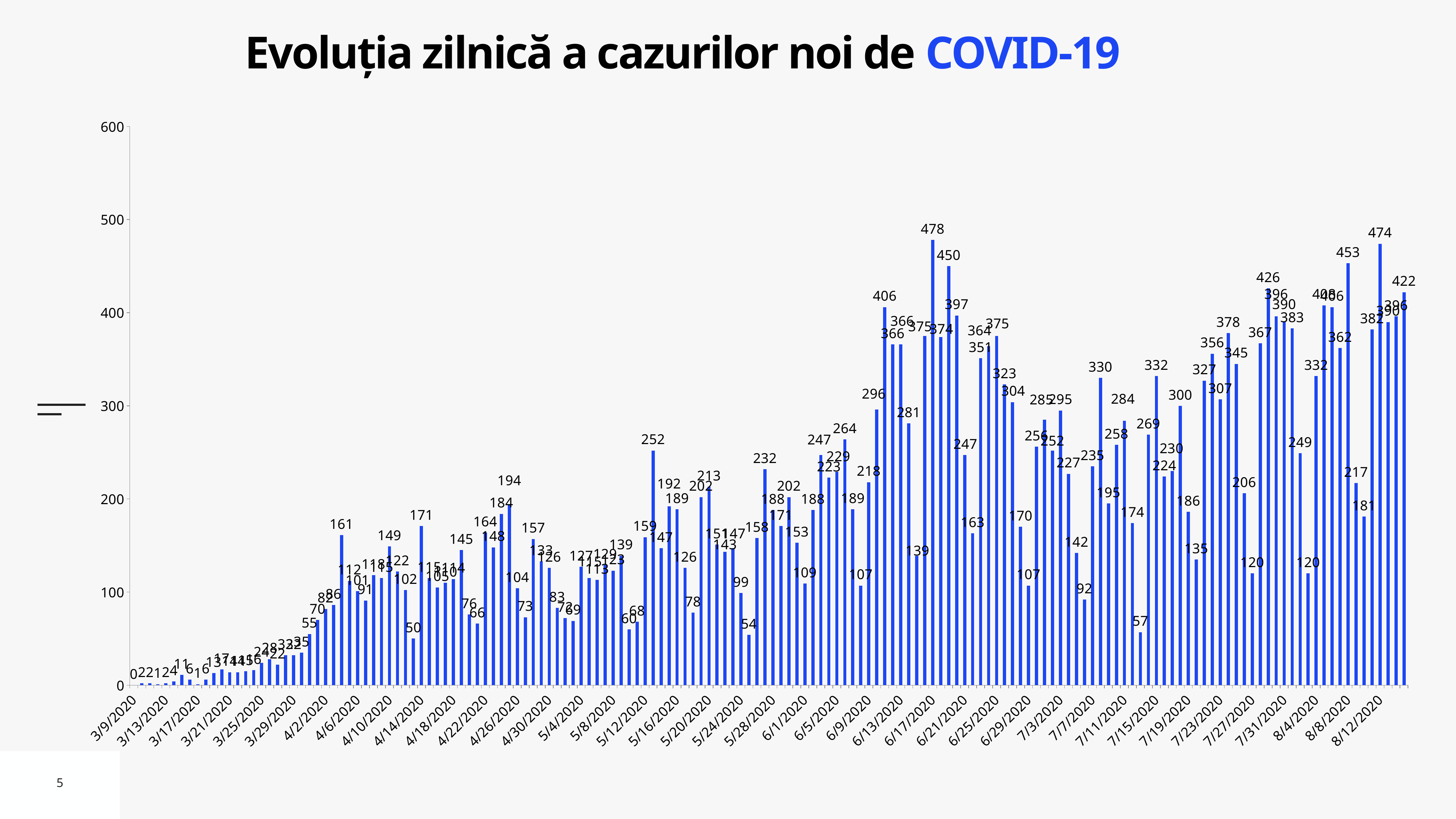
What is the highest daily value shown in the chart? 478 What is the value of the first bar, for 3/9/2020? 0 What is the second highest data label shown in the chart? 474 What is the difference between the bar labelled 478 and the bar labelled 453? 25 Overall, do the daily values rise or fall from March to August along the x axis? rise What kind of chart is shown on the slide? bar chart What is the difference between the highest value, 478, and the bar labelled 474? 4 Which is larger, the bar labelled 450 or the bar labelled 478? 478 Is the highest bar in the chart greater or less than 400? greater What is the title of the chart? Evoluția zilnică a cazurilor noi de COVID-19 Is the highest bar in the chart greater or less than 500? less What is the maximum value shown on the vertical axis? 600